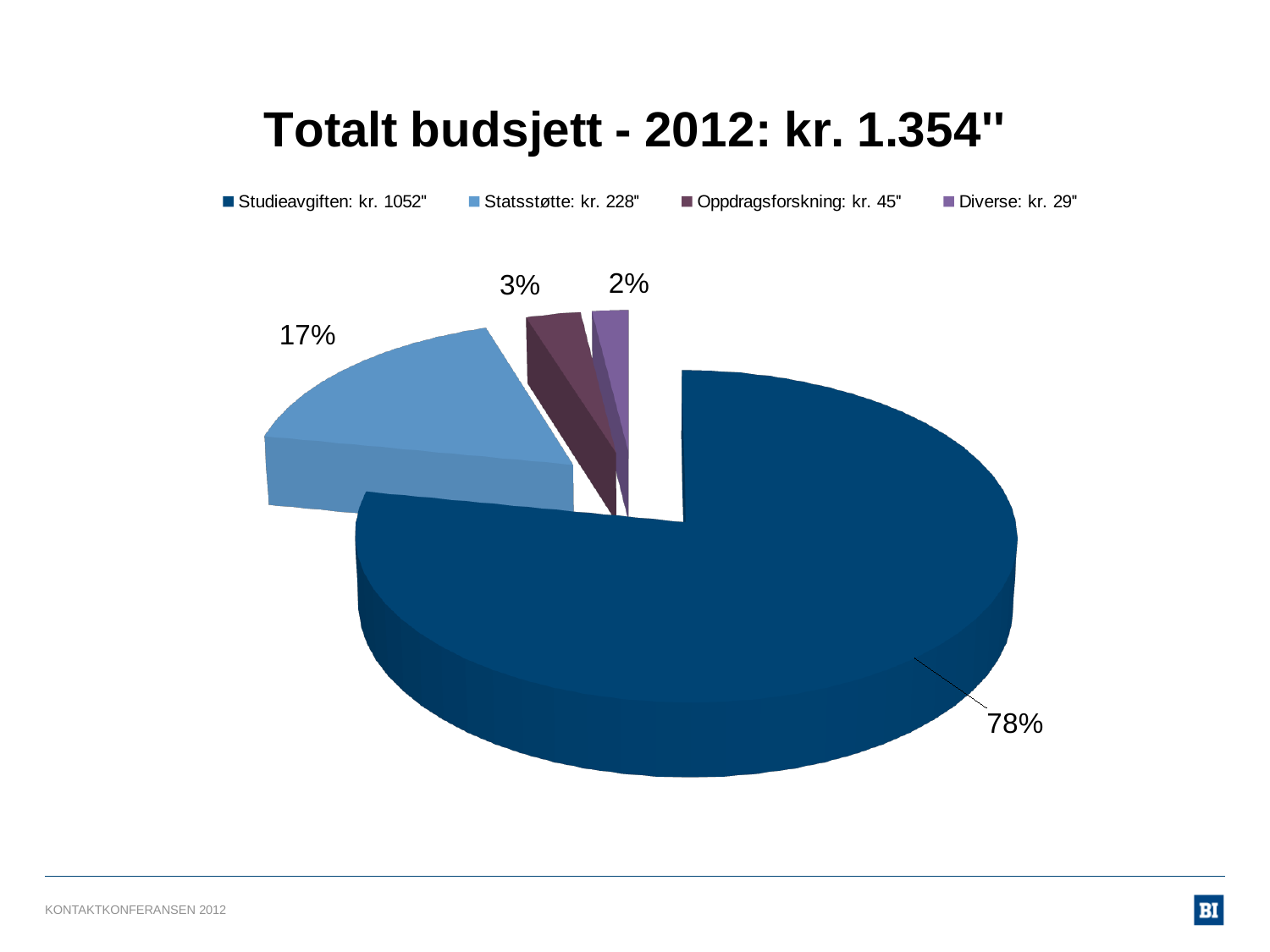
Which category has the largest slice of the pie? Studieavgiften What is the difference in percentage points between the Studieavgiften share and the Statsstøtte share? 61 percentage points What share of the pie does Studieavgiften represent? 78% What share of the pie does Oppdragsforskning represent? 3% Which category has the smallest slice of the pie? Diverse What is the title of the chart? Totalt budsjett - 2012: kr. 1.354" What share of the pie does Diverse represent? 2% What amount does the legend give for Statsstøtte? kr. 228" How many slices does the pie chart have? 4 Which is larger, the share for Statsstøtte or the share for Oppdragsforskning? Statsstøtte What kind of chart is shown on the slide? pie chart